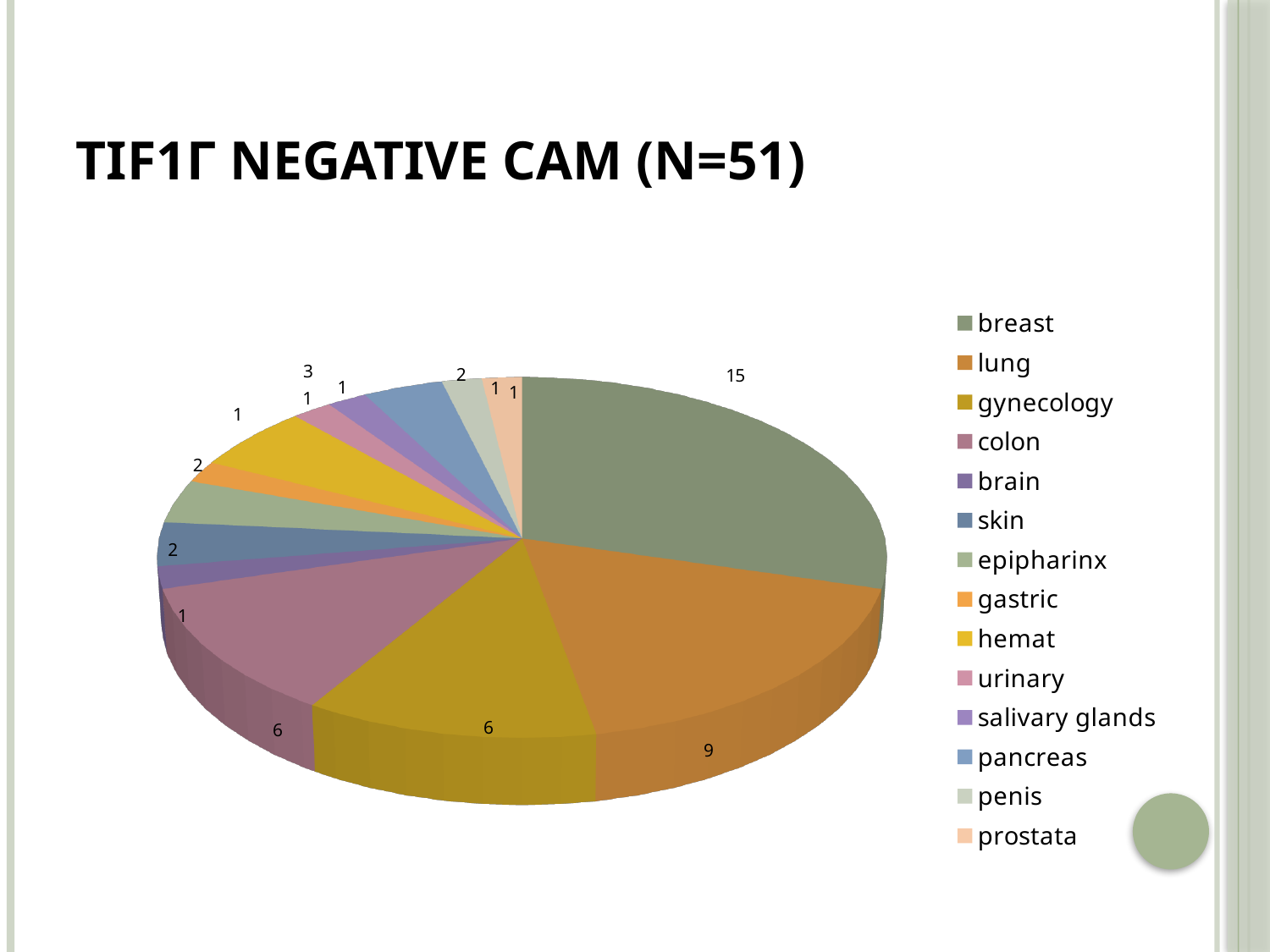
What is the value for gynecology? 6 What is the value for breast? 15 What kind of chart is shown on the slide? pie chart What is the difference between the values for breast and lung? 6 What is the difference between the values for hemat and skin? 1 What is the value for lung? 9 What is the value for hemat? 3 Which category has the largest slice of the pie? breast How many categories does the legend list? 14 Which category is listed last in the legend? prostata Which is larger, the value for lung or the value for colon? lung What is the title of the chart slide? TIF1Γ NEGATIVE CAM (N=51)